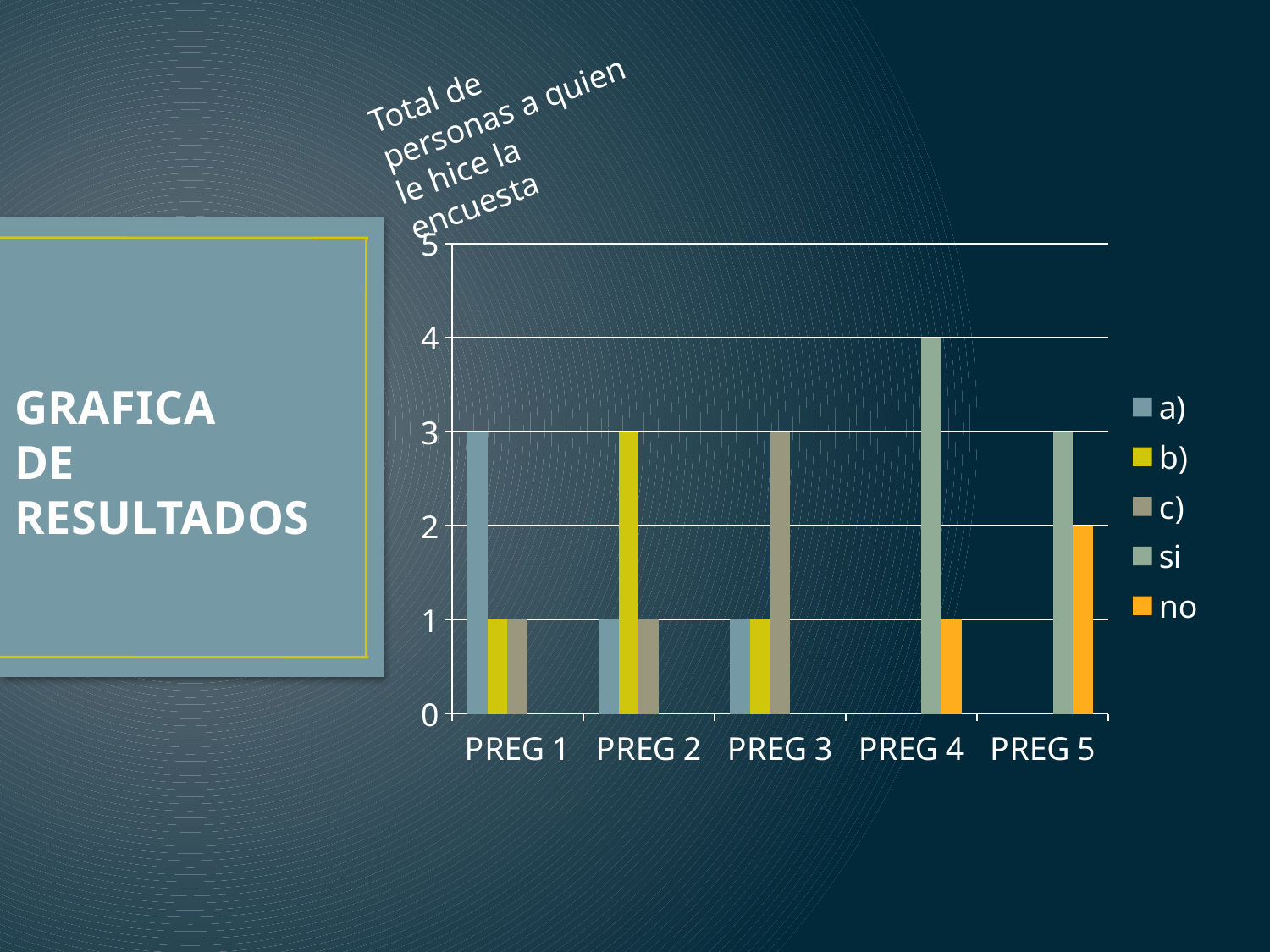
How many categories are shown on the x axis? 5 What is the value for series a) in PREG 1? 3 Which is larger in PREG 5, the value for si or the value for no? si What kind of chart is shown on the slide? bar chart What is the value for series b) in PREG 2? 3 How many series does the legend list? 5 What is the difference between the si and no values in PREG 4? 3 What is the title of the vertical axis of the chart? Total de personas a quien le hice la encuesta What is the value for series c) in PREG 3? 3 What is the value for series no in PREG 5? 2 Which category has the tallest bar in the chart? PREG 4 What is the value for series si in PREG 4? 4